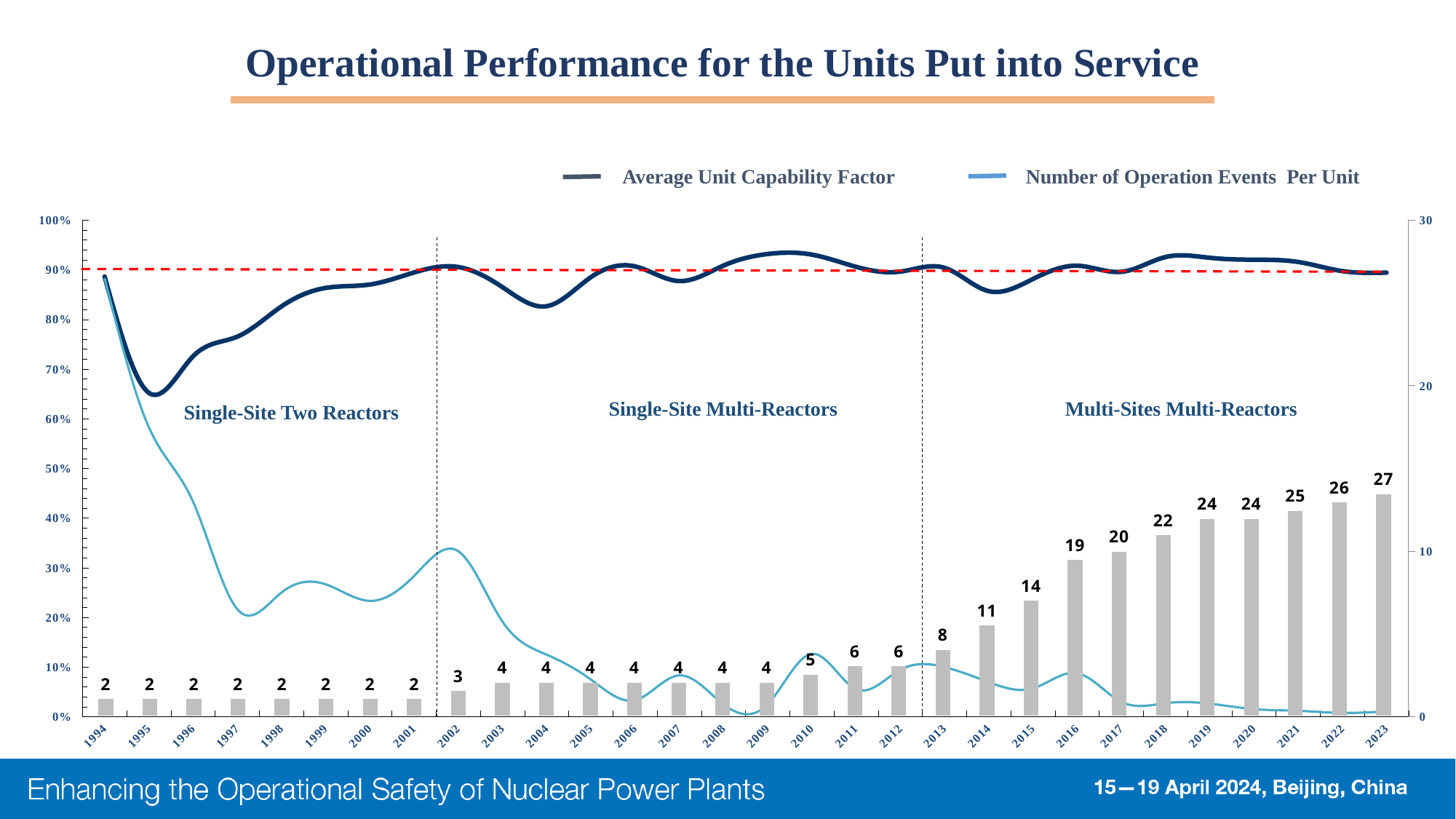
Is the Average Unit Capability Factor for 1995 greater or less than 70%? less What is the difference between the bar values for 2023 and 2013? 19 What is the bar value for 2023? 27 What is the bar value for 2015? 14 What is the lowest bar value shown on the chart? 2 What is the bar value for 2002? 3 Which year has the highest bar value? 2023 Is the Average Unit Capability Factor for 2004 greater or less than 90%? less How many years are shown on the x axis? 30 How many series does the legend list? 2 Which year has a larger bar value, 2016 or 2014? 2016 Do the bar values rise or fall from 2013 to 2023? rise